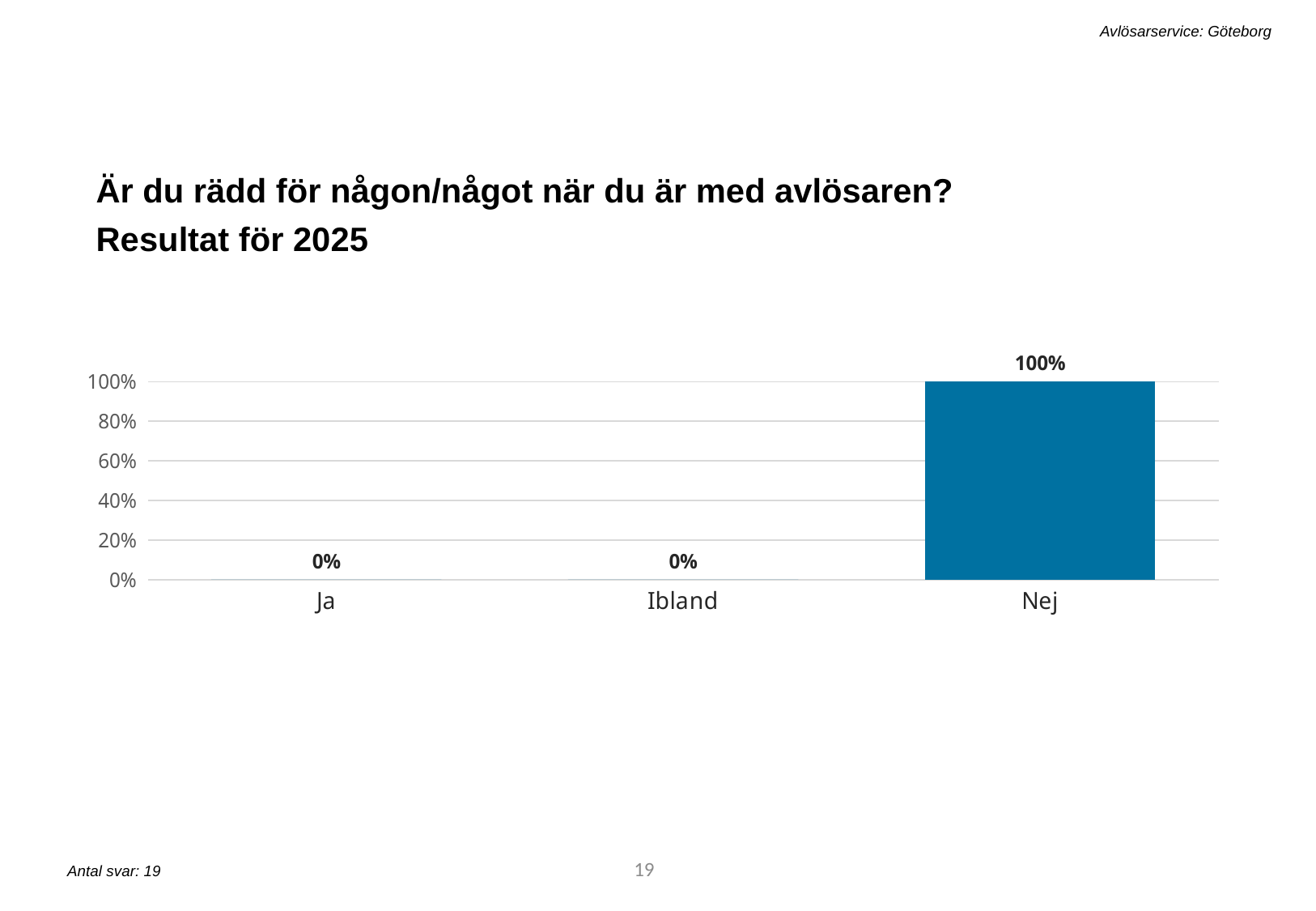
What colour is the bar for Nej? blue What is the value for Nej? 100% What is the value for Ja? 0% Which is larger, the value for Nej or the value for Ibland? Nej How many categories are shown on the x axis? 3 What is the total of the values for Ja, Ibland and Nej? 100% Is the value for Nej greater or less than 80%? greater What is the value for Ibland? 0% What kind of chart is shown on the slide? bar chart What is the difference between the values for Nej and Ja? 100% Which category has the highest value? Nej What is the highest tick value shown on the y axis? 100%